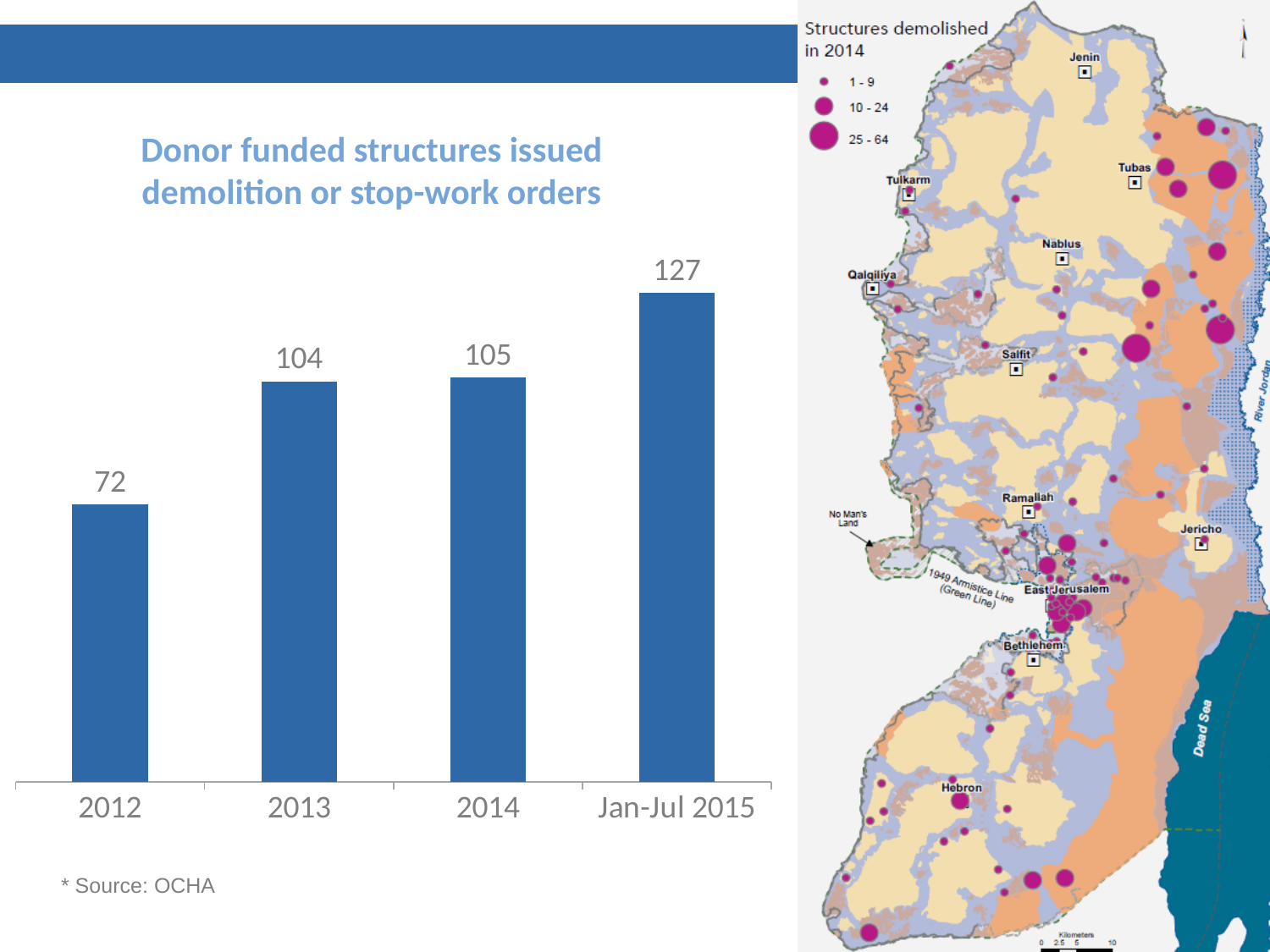
Which is larger, the value for 2012 or the value for 2014? 2014 What is the value for 2013? 104 What is the difference between the values for 2013 and 2012? 32 Which category has the lowest value? 2012 What is the value for 2012? 72 Do the values rise or fall from 2012 to Jan-Jul 2015? rise What is the value for Jan-Jul 2015? 127 How many categories are shown on the x axis? 4 What is the difference between the values for Jan-Jul 2015 and 2012? 55 Which category has the highest value? Jan-Jul 2015 What is the value for 2014? 105 What kind of chart is shown? bar chart